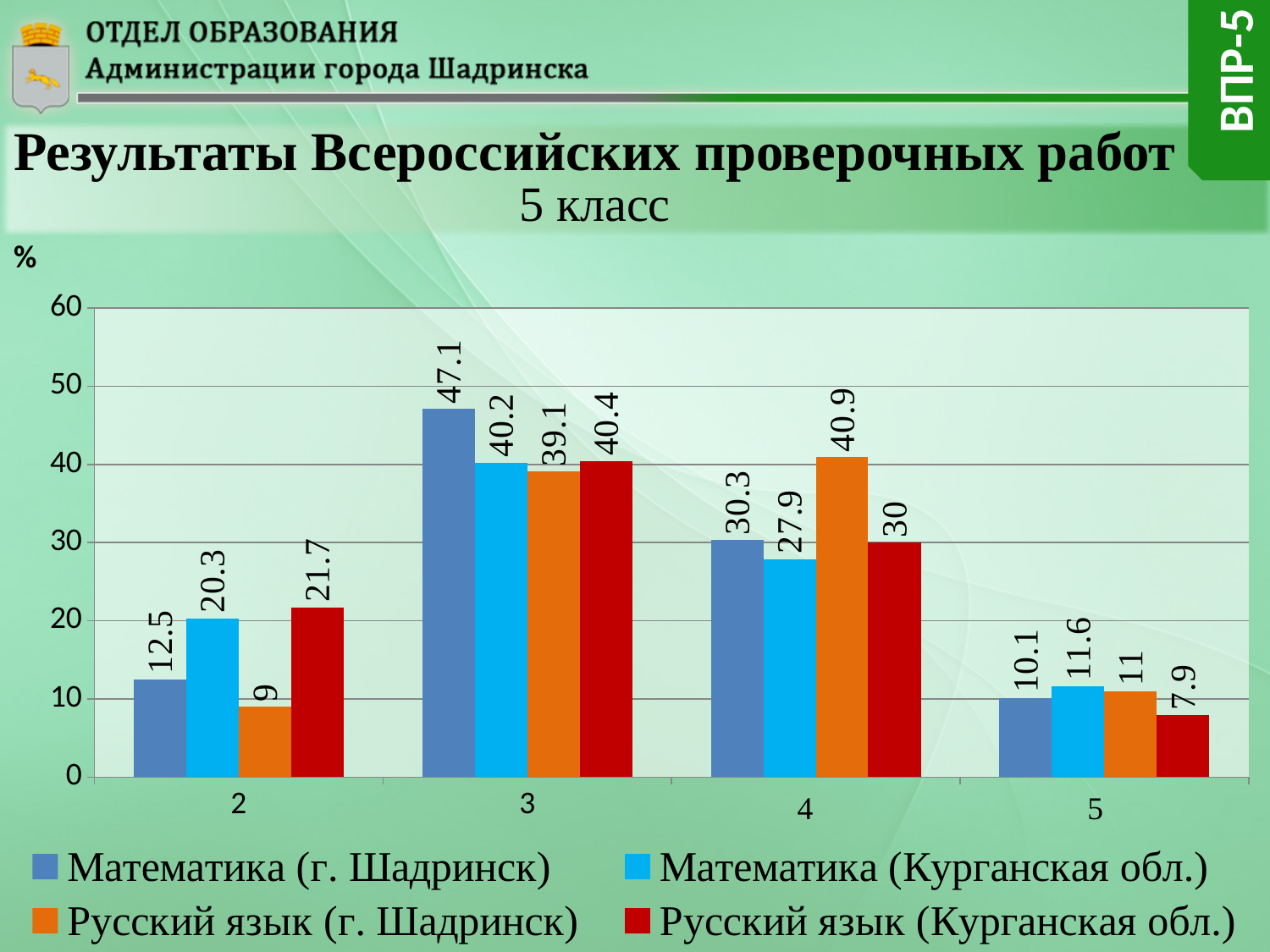
What is the value for Математика (г. Шадринск) at category 3? 47.1 At category 4, which is larger: Русский язык (г. Шадринск) or Русский язык (Курганская обл.)? Русский язык (г. Шадринск) For the series Русский язык (Курганская обл.), which category has the lowest value? 5 What is the value for Математика (Курганская обл.) at category 5? 11.6 How many series does the legend list? 4 What kind of chart is shown on the slide? bar chart What is the value for Русский язык (Курганская обл.) at category 2? 21.7 What is the total of the four values at category 5? 40.6 How many categories are shown on the x axis? 4 What is the value for Русский язык (г. Шадринск) at category 4? 40.9 What is the difference between Математика (г. Шадринск) and Математика (Курганская обл.) at category 3? 6.9 For the series Математика (г. Шадринск), which category has the highest value? 3